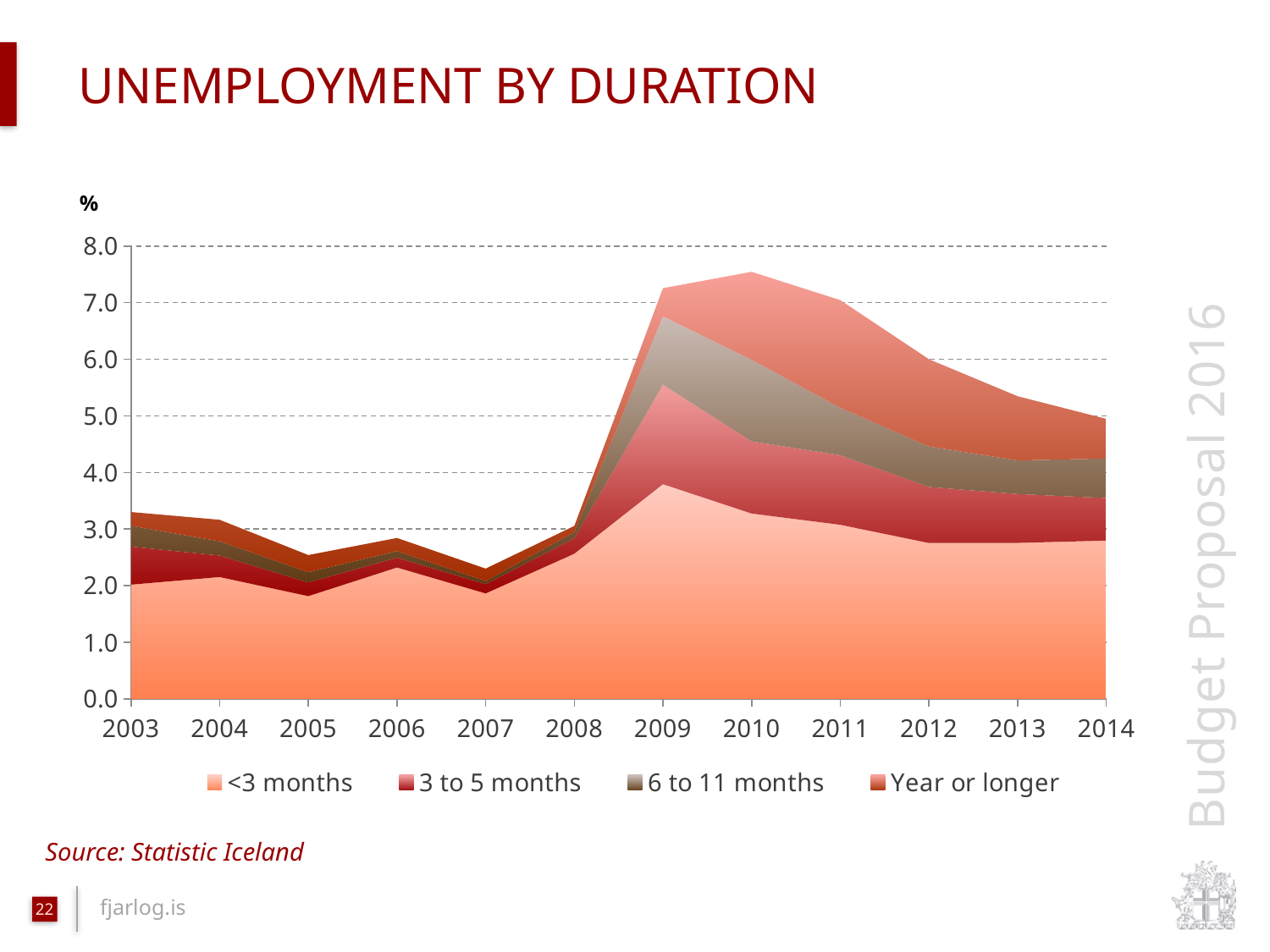
Is the total unemployment rate in 2003 greater or less than 3.0? greater In which year is the total unemployment rate (top of the stacked areas) lowest? 2007 How many years are shown along the x axis? 12 Does the total unemployment rate rise or fall from 2010 to 2014? Fall What kind of chart is shown on the slide? Stacked area chart In which year is the total unemployment rate (top of the stacked areas) highest? 2010 How many series does the legend list? 4 Is the total unemployment rate in 2010 greater or less than 7.0? greater What source is cited for the chart? Statistic Iceland Is the total unemployment rate in 2014 greater or less than 6.0? less Which year has the larger total unemployment rate, 2008 or 2009? 2009